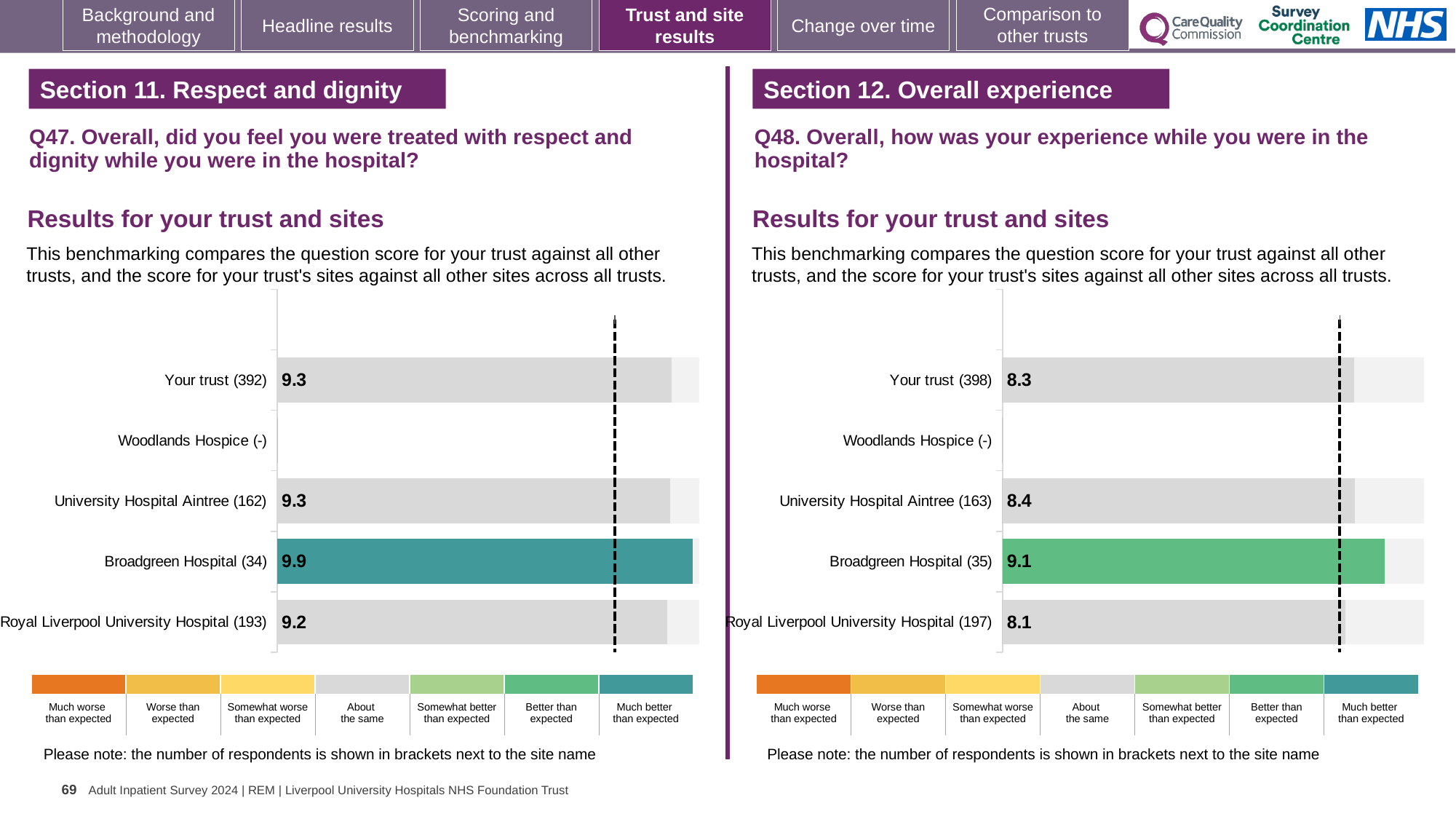
In the Q48 chart on the right, what is the score for Royal Liverpool University Hospital? 8.1 How many categories does the colour key below the Q48 chart on the right list? 7 In the Q48 chart on the right, what is the score for Your trust? 8.3 In the Q48 chart on the right, what is the difference between the scores for Broadgreen Hospital and Your trust? 0.8 In the Q47 chart on the left, which site has the highest score? Broadgreen Hospital In the Q48 chart on the right, which site has the lowest score? Royal Liverpool University Hospital In the Q47 chart on the left, what is the difference between the scores for Broadgreen Hospital and Royal Liverpool University Hospital? 0.7 In the Q48 chart on the right, which has the higher score: University Hospital Aintree or Your trust? University Hospital Aintree What kind of chart is used for the Q48 results on the right? Bar chart In the Q47 chart on the left, what is the score for Broadgreen Hospital? 9.9 How many sites or categories are listed on the y axis of the Q47 chart on the left? 5 In the Q47 chart on the left, which benchmark category does the colour of the Broadgreen Hospital bar correspond to? Much better than expected